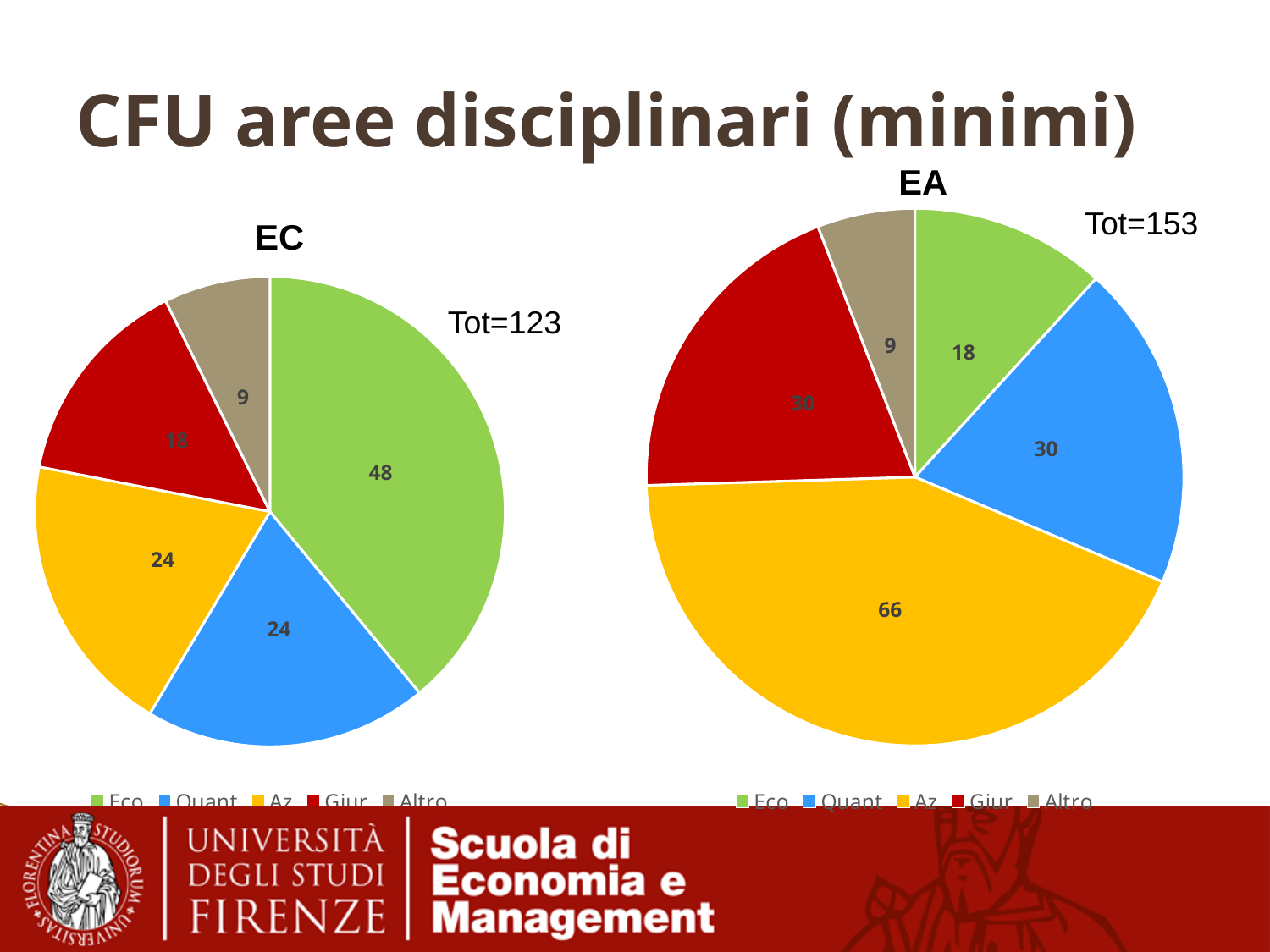
In the EC pie chart, what is the difference between the Eco value and the Giur value? 30 In the EA pie chart, what is the value for Az? 66 In the EC pie chart, what is the value for Eco? 48 In the EA pie chart, what is the value for Altro? 9 In the EC pie chart, which category has the largest slice? Eco Which colour represents Giur in the legend of the pie charts? Red How many slices does the EC pie chart have? 5 What total is shown next to the EA pie chart? Tot=153 What type of chart is the EA chart? Pie chart In the EA pie chart, which is larger, the Az slice or the Quant slice? Az In the EA pie chart, which category has the smallest slice? Altro